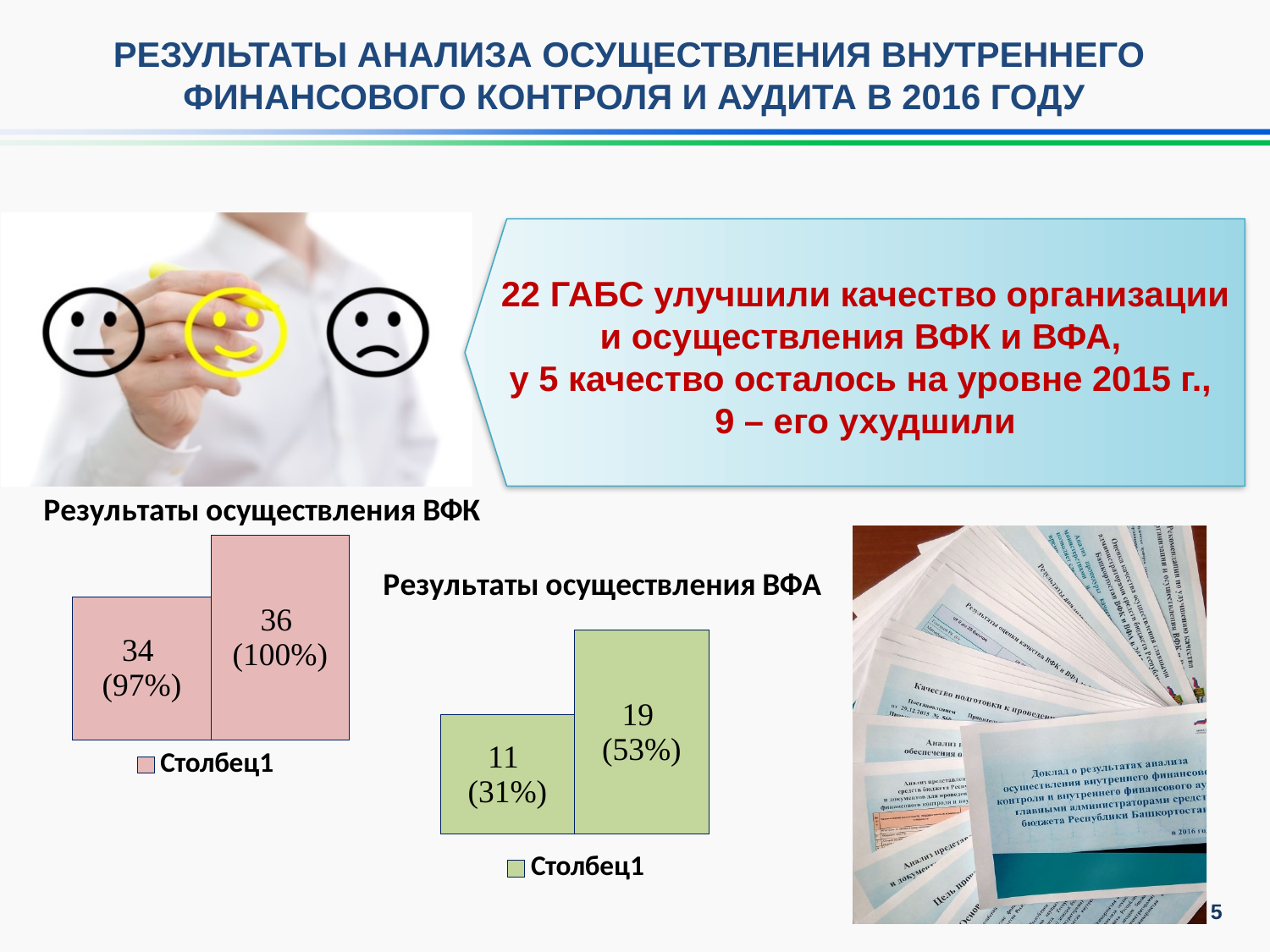
In the chart "Результаты осуществления ВФА", which bar is the lowest? the left bar (11) In the chart "Результаты осуществления ВФК", how many bars are plotted? 2 What kind of chart is "Результаты осуществления ВФК"? bar chart In the chart "Результаты осуществления ВФА", what value is printed on the right bar? 19 (53%) In the chart "Результаты осуществления ВФА", how many entries does the legend list? 1 In the chart "Результаты осуществления ВФК", what value is printed on the right bar? 36 (100%) What legend entry is shown under the chart "Результаты осуществления ВФК"? Столбец1 In the chart "Результаты осуществления ВФА", what value is printed on the left bar? 11 (31%) In the chart "Результаты осуществления ВФК", what value is printed on the left bar? 34 (97%) In the chart "Результаты осуществления ВФК", which bar is taller, the left or the right? right